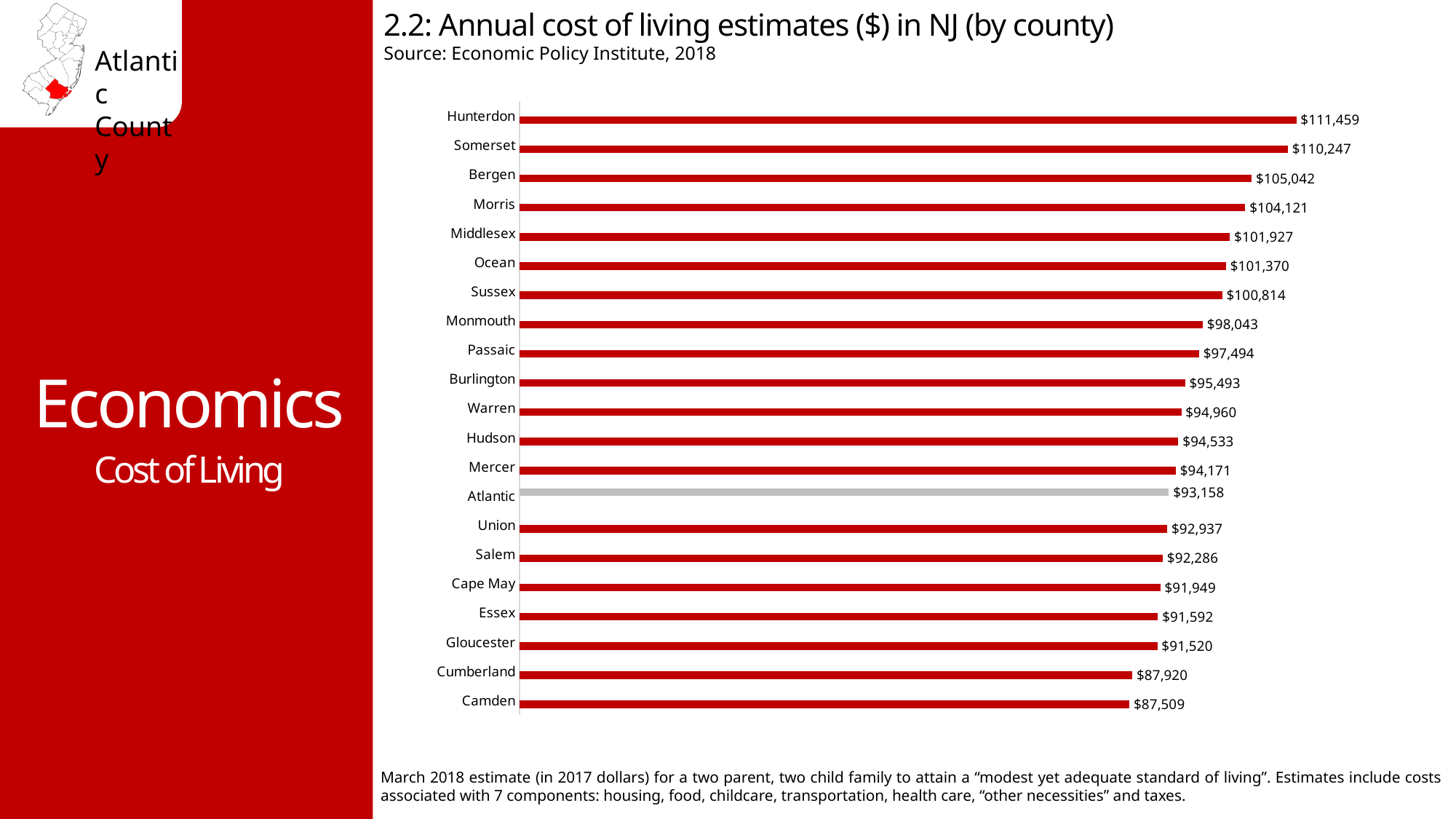
What is the difference between the cost of living estimates for Hunterdon and Camden? $23,950 What is the difference between the cost of living estimates for Atlantic and Union? $221 What is the annual cost of living estimate for Atlantic County? $93,158 How many counties are shown in the chart? 21 What type of chart is used to show the cost of living estimates? Bar chart Which county has a higher cost of living estimate, Salem or Cape May? Salem Which county has the lowest annual cost of living estimate? Camden What is the annual cost of living estimate for Cumberland County? $87,920 Which county's bar is shown in grey instead of red? Atlantic What is the annual cost of living estimate for Bergen County? $105,042 Which county has a higher cost of living estimate, Bergen or Morris? Bergen Which county has the highest annual cost of living estimate? Hunterdon